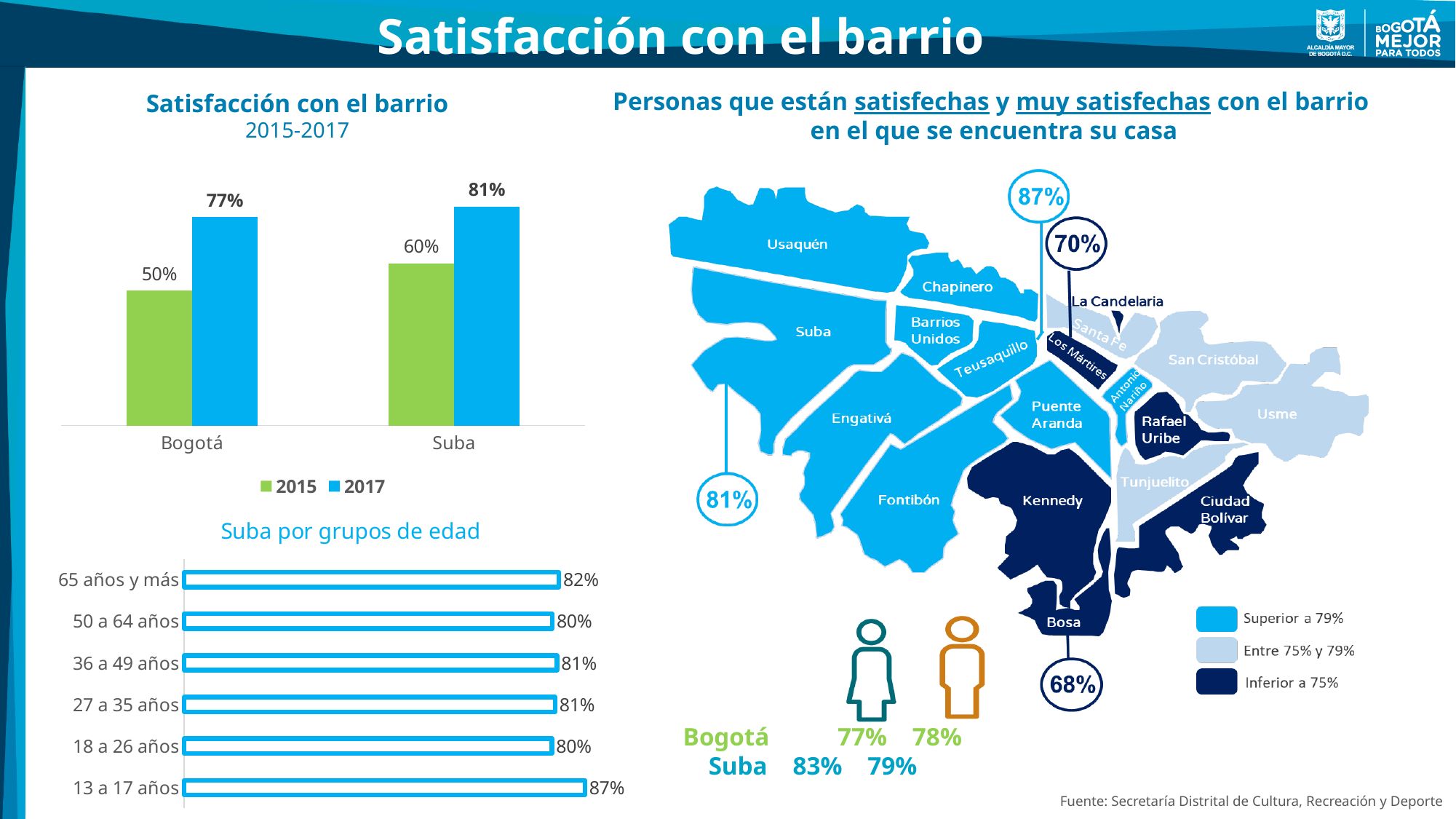
In the 'Satisfacción con el barrio 2015-2017' chart, what is the value for Suba in 2015? 60% In the 'Satisfacción con el barrio 2015-2017' chart, how many series does the legend list? 2 In the 'Satisfacción con el barrio 2015-2017' chart, which is larger: Suba in 2017 or Bogotá in 2017? Suba in 2017 In the 'Satisfacción con el barrio 2015-2017' chart, what is the value for Bogotá in 2017? 77% In the 'Suba por grupos de edad' chart, what is the value for 36 a 49 años? 81% What kind of chart is 'Suba por grupos de edad'? Bar chart In the 'Satisfacción con el barrio 2015-2017' chart, what colour represents 2015? Green In the 'Suba por grupos de edad' chart, how many age groups are shown? 6 In the 'Satisfacción con el barrio 2015-2017' chart, by how many percentage points did Bogotá's value increase from 2015 to 2017? 27 percentage points In the 'Suba por grupos de edad' chart, what is the difference between the values for 13 a 17 años and 18 a 26 años? 7 percentage points In the 'Suba por grupos de edad' chart, which age group has the highest value? 13 a 17 años In the 'Suba por grupos de edad' chart, what is the value for 65 años y más? 82%